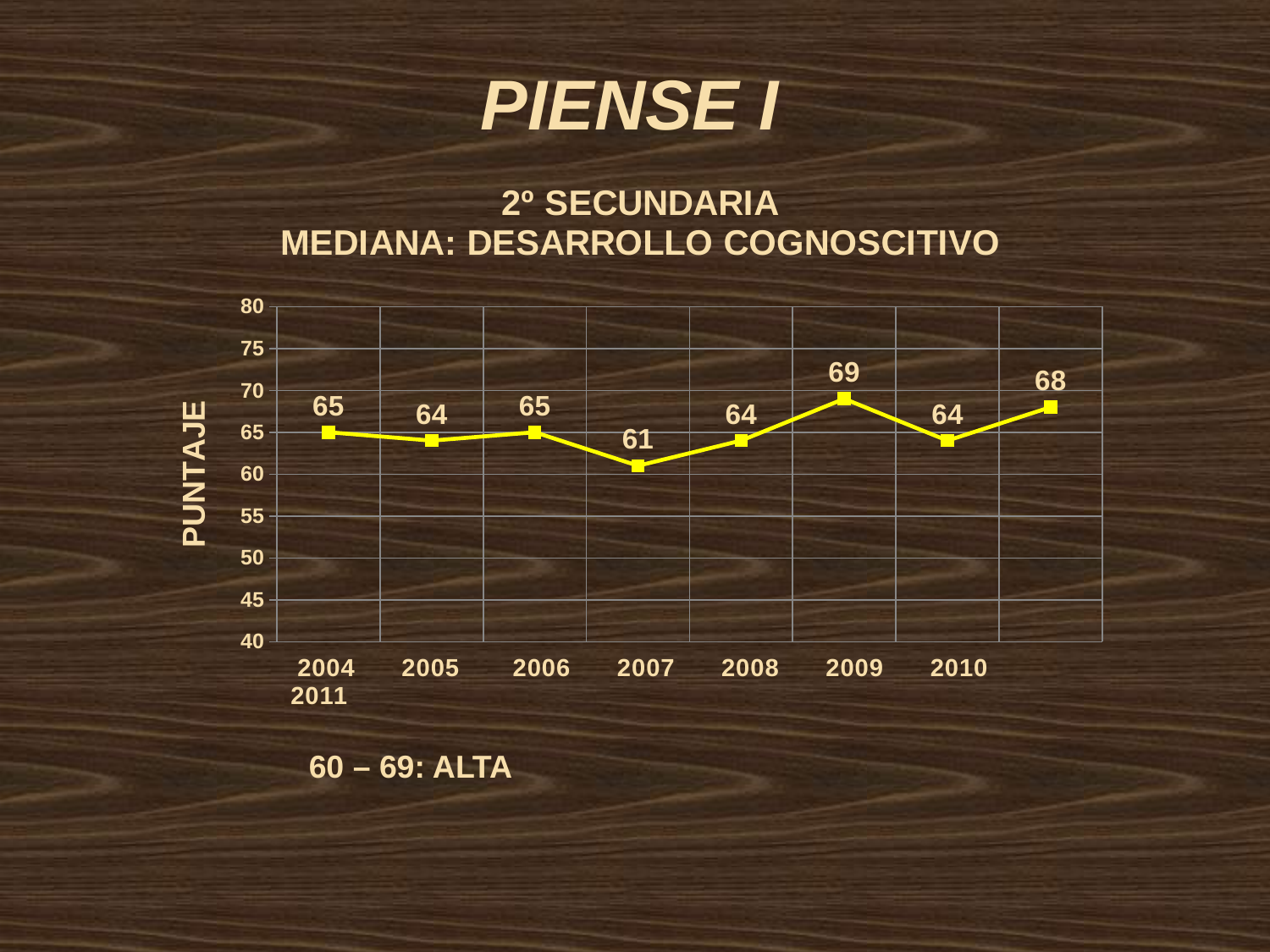
Which is larger, the value for 2006 or the value for 2008? 2006 Does the value rise or fall from 2008 to 2009? rise What type of chart is shown on the slide? line chart What is the title of the vertical axis? PUNTAJE What is the value for 2009? 69 What is the value for 2007? 61 Which year has the highest value? 2009 What is the value for 2004? 65 What is the difference between the values for 2009 and 2007? 8 Which year has the lowest value? 2007 How many data points are plotted on the line? 8 What is the value for 2010? 64